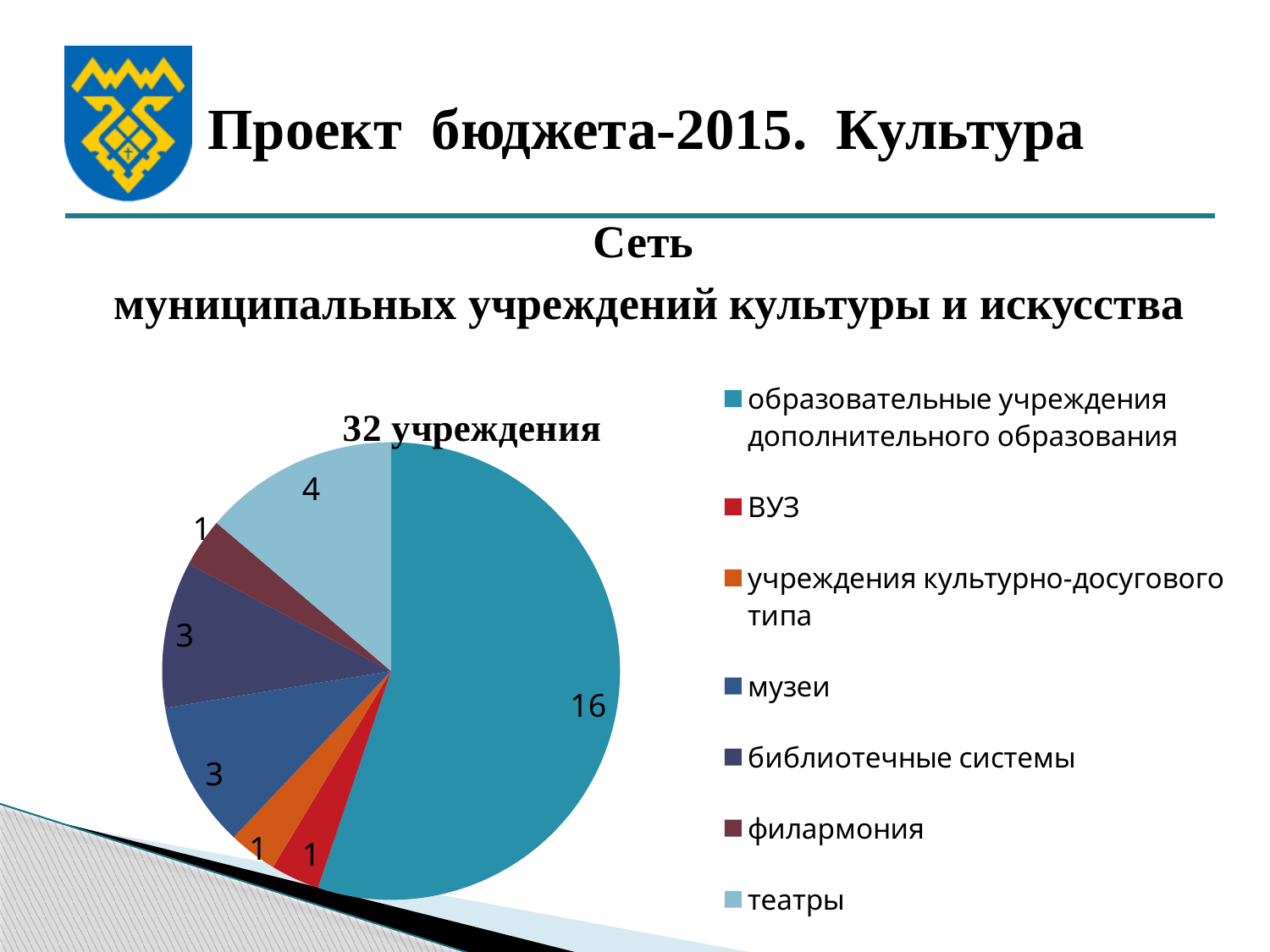
What is the value for театры? 4 What is the value for образовательные учреждения дополнительного образования? 16 Which category has the largest slice of the pie? образовательные учреждения дополнительного образования How many categories does the legend of the pie chart list? 7 Which is larger, the value for театры or the value for библиотечные системы? театры What is the value for филармония? 1 What is the difference between the values for образовательные учреждения дополнительного образования and театры? 12 What is the difference between the values for театры and ВУЗ? 3 What is the title of the pie chart? 32 учреждения Which legend entry is shown in red? ВУЗ What kind of chart is shown on the slide? pie chart What is the value for музеи? 3